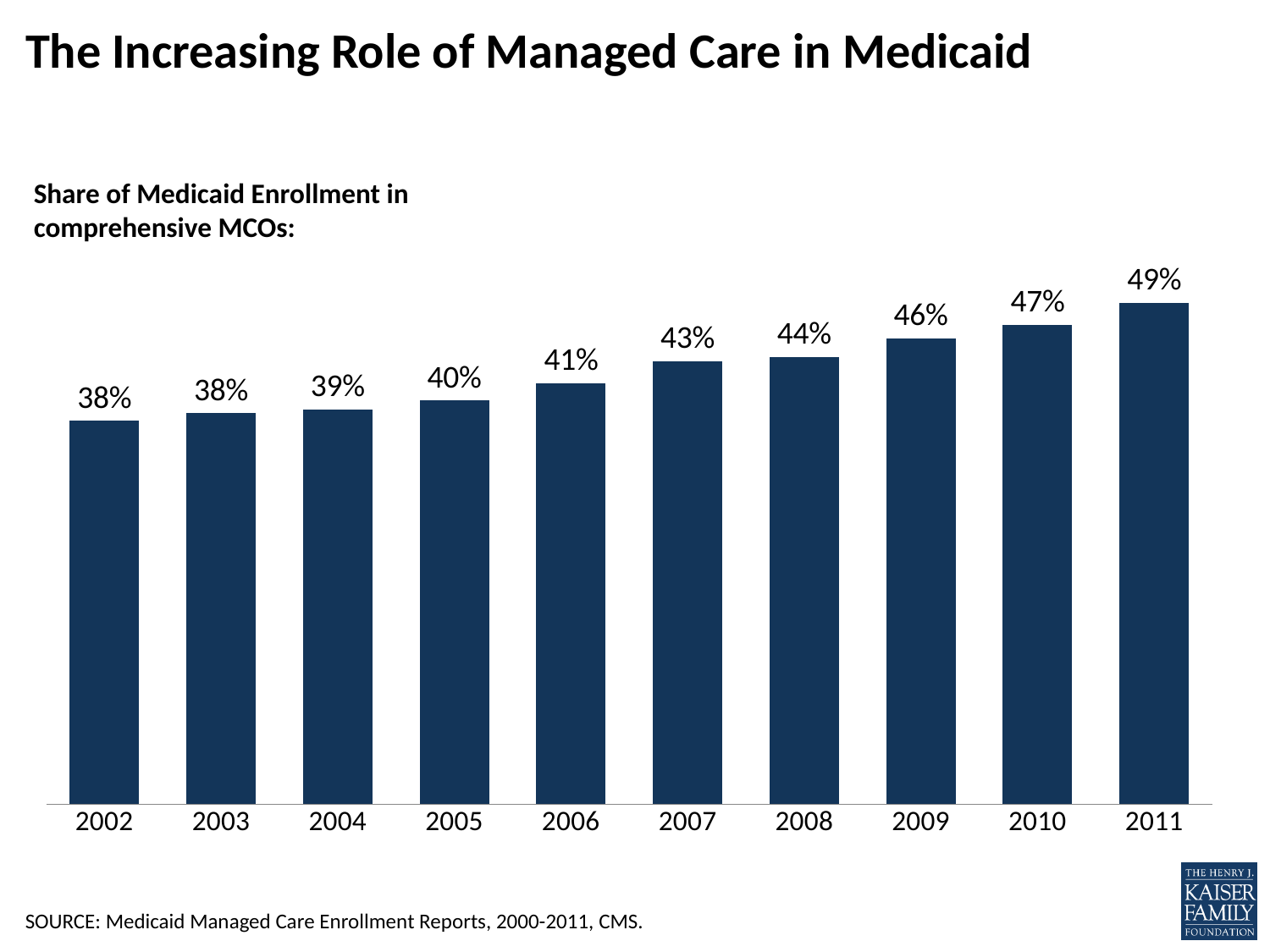
What is the value shown for 2011? 49% Which is larger, the value for 2008 or the value for 2005? 2008 What kind of chart is shown on the slide? Bar chart Do the values rise or fall from 2002 to 2011? Rise What share of Medicaid enrollment was in comprehensive MCOs in 2006? 41% What is the difference between the 2011 value and the 2002 value? 11 percentage points Which year has the highest share of Medicaid enrollment in comprehensive MCOs? 2011 What is the difference between the values for 2009 and 2007? 3 percentage points What source is cited for the chart data? Medicaid Managed Care Enrollment Reports, 2000-2011, CMS. What is the title of the slide? The Increasing Role of Managed Care in Medicaid What is the value shown for 2002? 38% How many years are shown on the x axis? 10